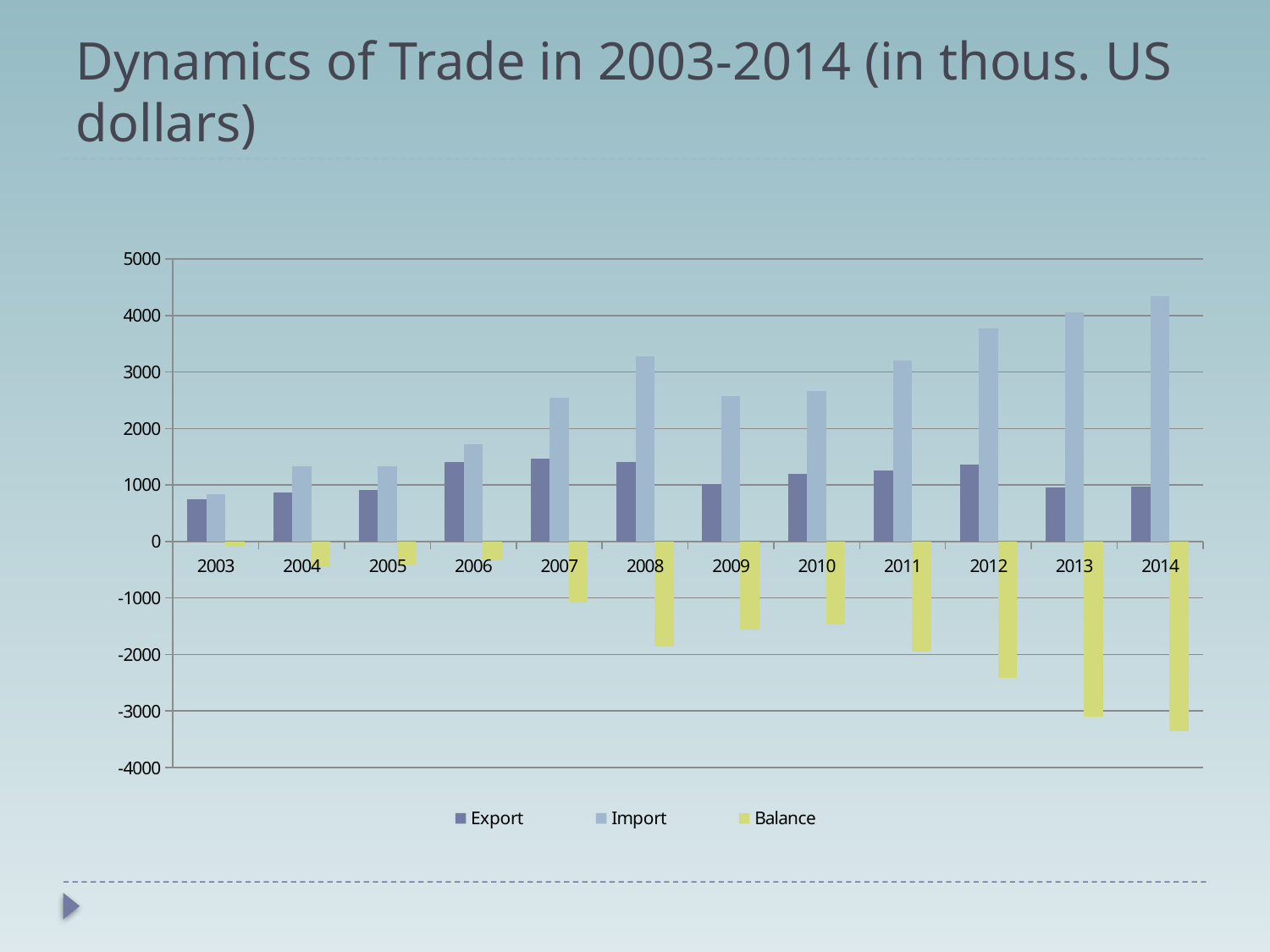
Is the Import value for 2014 greater or less than 4000? greater Which is larger, Import in 2008 or Import in 2009? Import in 2008 What kind of chart is shown on the slide? bar chart What are the three series named in the legend? Export, Import, Balance How many series does the legend list? 3 In which year is Import highest? 2014 How many years are shown on the x axis? 12 Is the Balance value for 2013 greater or less than -3000? less In which year is Import lowest? 2003 In which year is the Balance lowest (most negative)? 2014 Does Import generally rise or fall from 2003 to 2014? rise Is the Export value for 2007 greater or less than 1000? greater